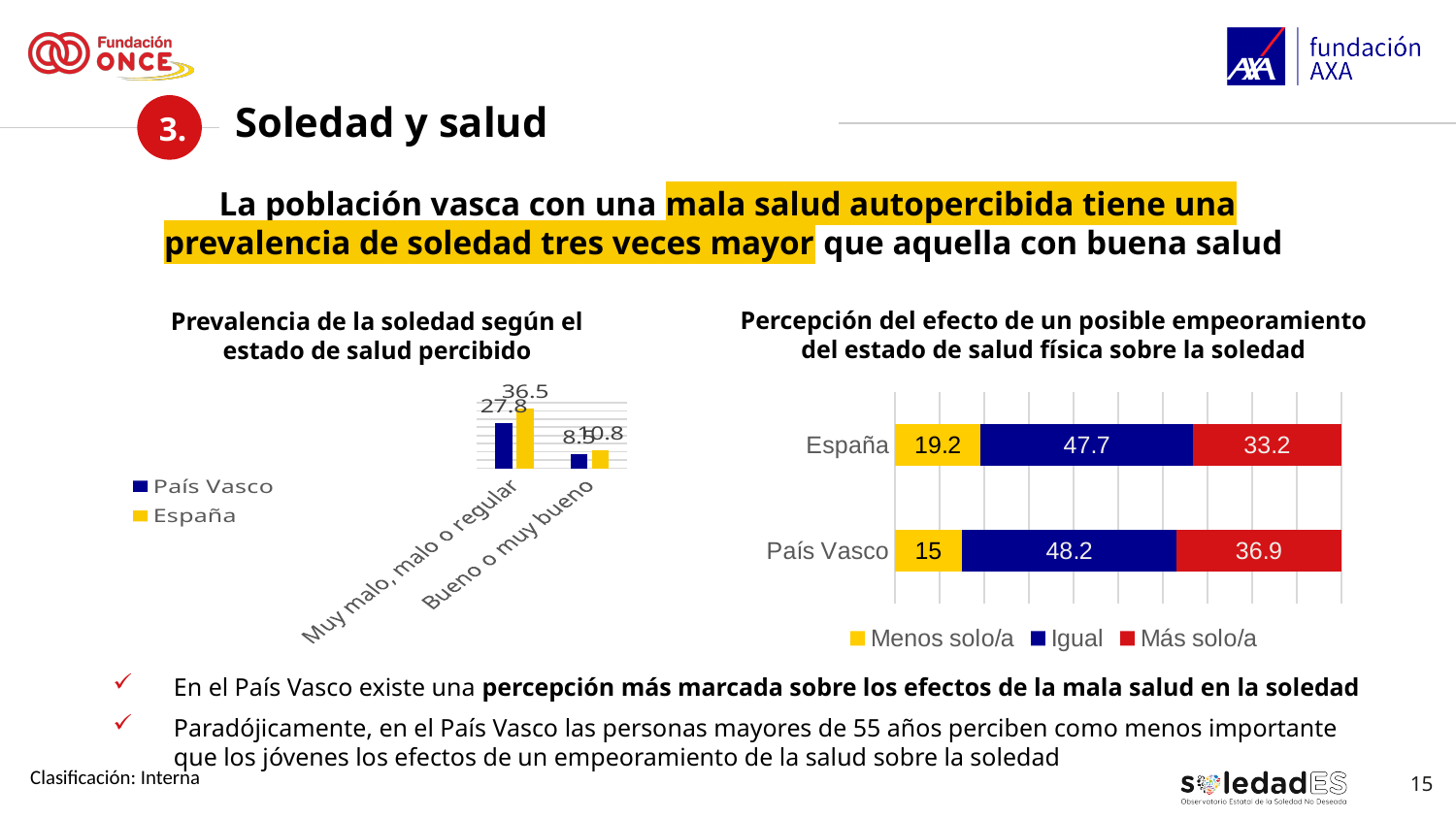
In the chart 'Percepción del efecto de un posible empeoramiento del estado de salud física sobre la soledad', which region has the larger 'Más solo/a' value, España or País Vasco? País Vasco In the chart 'Prevalencia de la soledad según el estado de salud percibido', which health category has the higher values? Muy malo, malo o regular In the chart 'Percepción del efecto de un posible empeoramiento del estado de salud física sobre la soledad', what is the 'Igual' value for País Vasco? 48.2 In the chart 'Percepción del efecto de un posible empeoramiento del estado de salud física sobre la soledad', what is the difference between the 'Menos solo/a' values for España and País Vasco? 4.2 In the chart 'Prevalencia de la soledad según el estado de salud percibido', what is the value for País Vasco in the 'Muy malo, malo o regular' category? 27.8 In the chart 'Prevalencia de la soledad según el estado de salud percibido', what is the difference between the España and País Vasco values for 'Muy malo, malo o regular'? 8.7 In the chart 'Percepción del efecto de un posible empeoramiento del estado de salud física sobre la soledad', what is the 'Menos solo/a' value for España? 19.2 What kind of chart is 'Percepción del efecto de un posible empeoramiento del estado de salud física sobre la soledad'? Stacked bar chart In the chart 'Prevalencia de la soledad según el estado de salud percibido', what is the value for España in the 'Muy malo, malo o regular' category? 36.5 In the chart 'Prevalencia de la soledad según el estado de salud percibido', how many series does the legend list? 2 In the chart 'Percepción del efecto de un posible empeoramiento del estado de salud física sobre la soledad', what is the 'Más solo/a' value for País Vasco? 36.9 In the chart 'Percepción del efecto de un posible empeoramiento del estado de salud física sobre la soledad', which colour represents 'Más solo/a'? Red